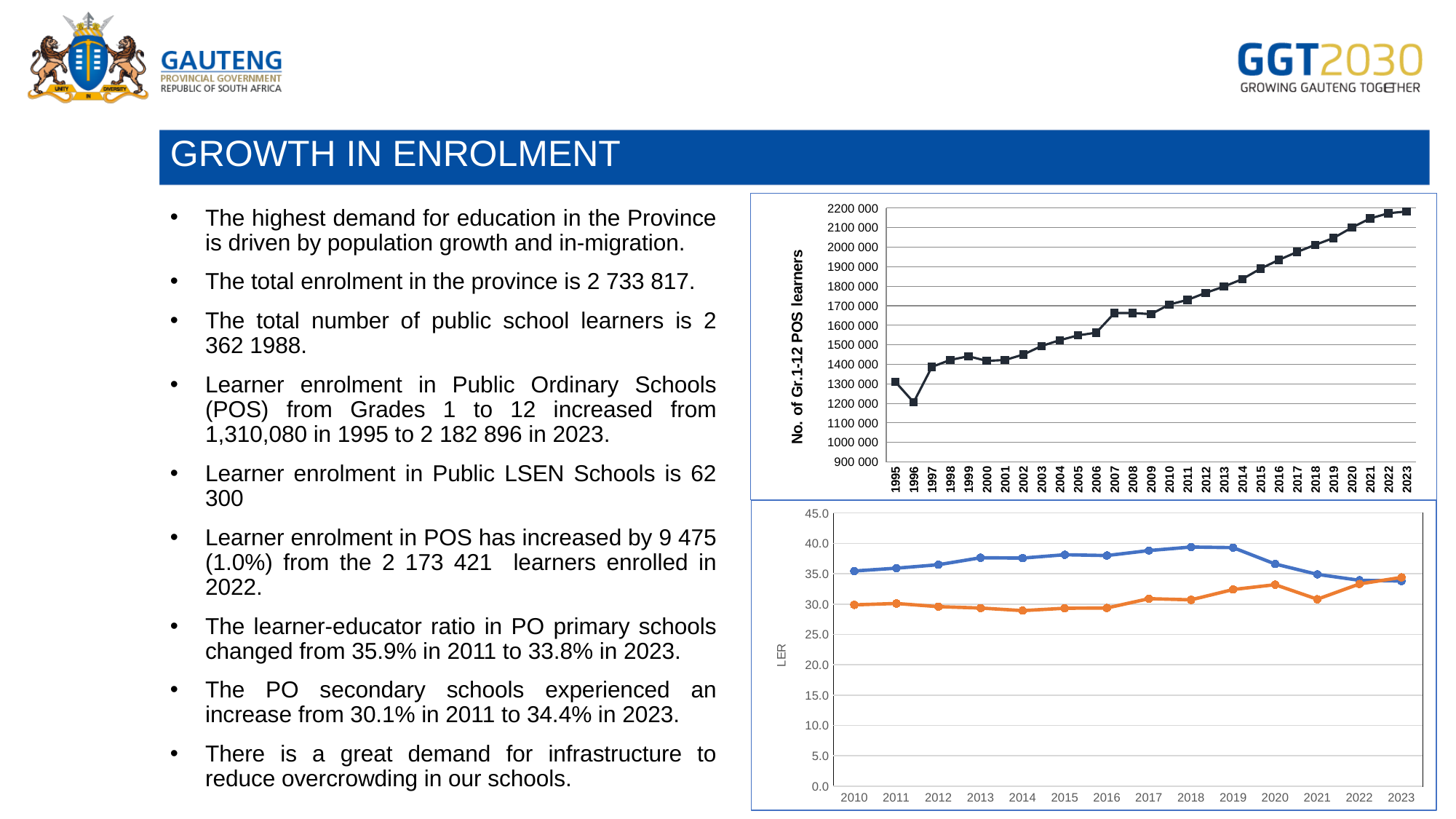
In the bottom chart, how many years are plotted along the x axis? 14 What is the y-axis label of the bottom chart? LER In the top chart, is the value for 2023 greater or less than 2100 000? greater In the top chart, is the value for 2007 greater or less than 1600 000? greater In the bottom chart, which line has the larger value in 2015, the blue line or the orange line? the blue line In the top chart, is the value for 1996 greater or less than 1300 000? less In the top chart, how many years are plotted along the x axis? 29 In the top chart, do the values generally rise or fall from 2009 to 2023? rise In the top chart, which year has the lowest number of Gr.1-12 POS learners? 1996 What kind of chart is the top chart on the slide? line chart In the top chart, which year has the highest number of Gr.1-12 POS learners? 2023